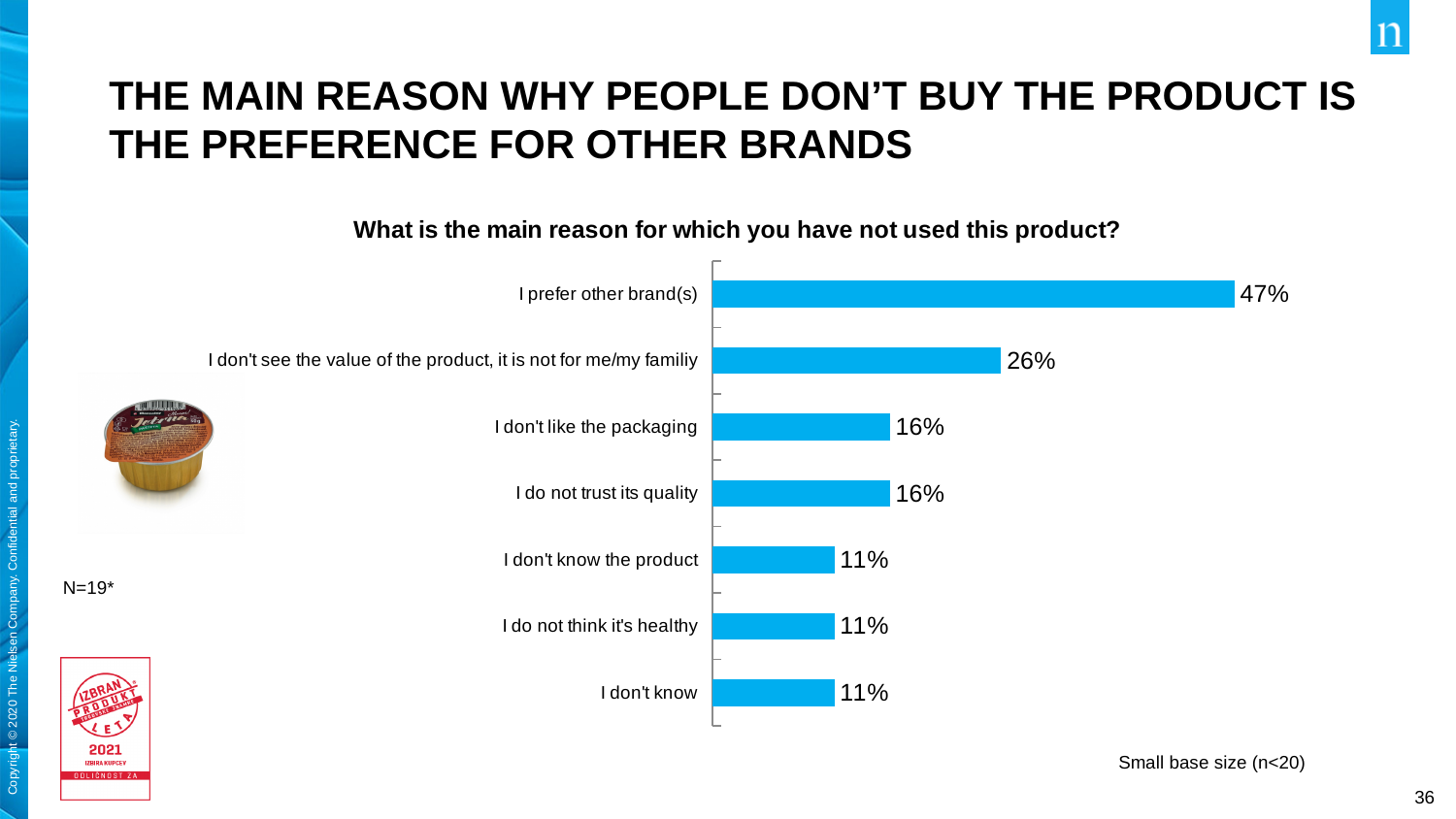
Which is larger, the value for "I don't like the packaging" or the value for "I don't know"? I don't like the packaging How many reasons (categories) are shown in the chart? 7 What kind of chart is shown on the slide? Bar chart What is the difference between "I do not trust its quality" and "I do not think it's healthy"? 5 percentage points What is the question shown as the chart's title? What is the main reason for which you have not used this product? What percentage of respondents said "I prefer other brand(s)"? 47% What is the value for "I don't see the value of the product, it is not for me/my familiy"? 26% What percentage of respondents said "I don't like the packaging"? 16% How many categories share the lowest value of 11%? 3 Which reason has the highest percentage? I prefer other brand(s) What is the difference between "I prefer other brand(s)" and "I don't see the value of the product, it is not for me/my familiy"? 21 percentage points What is the value for "I don't know the product"? 11%